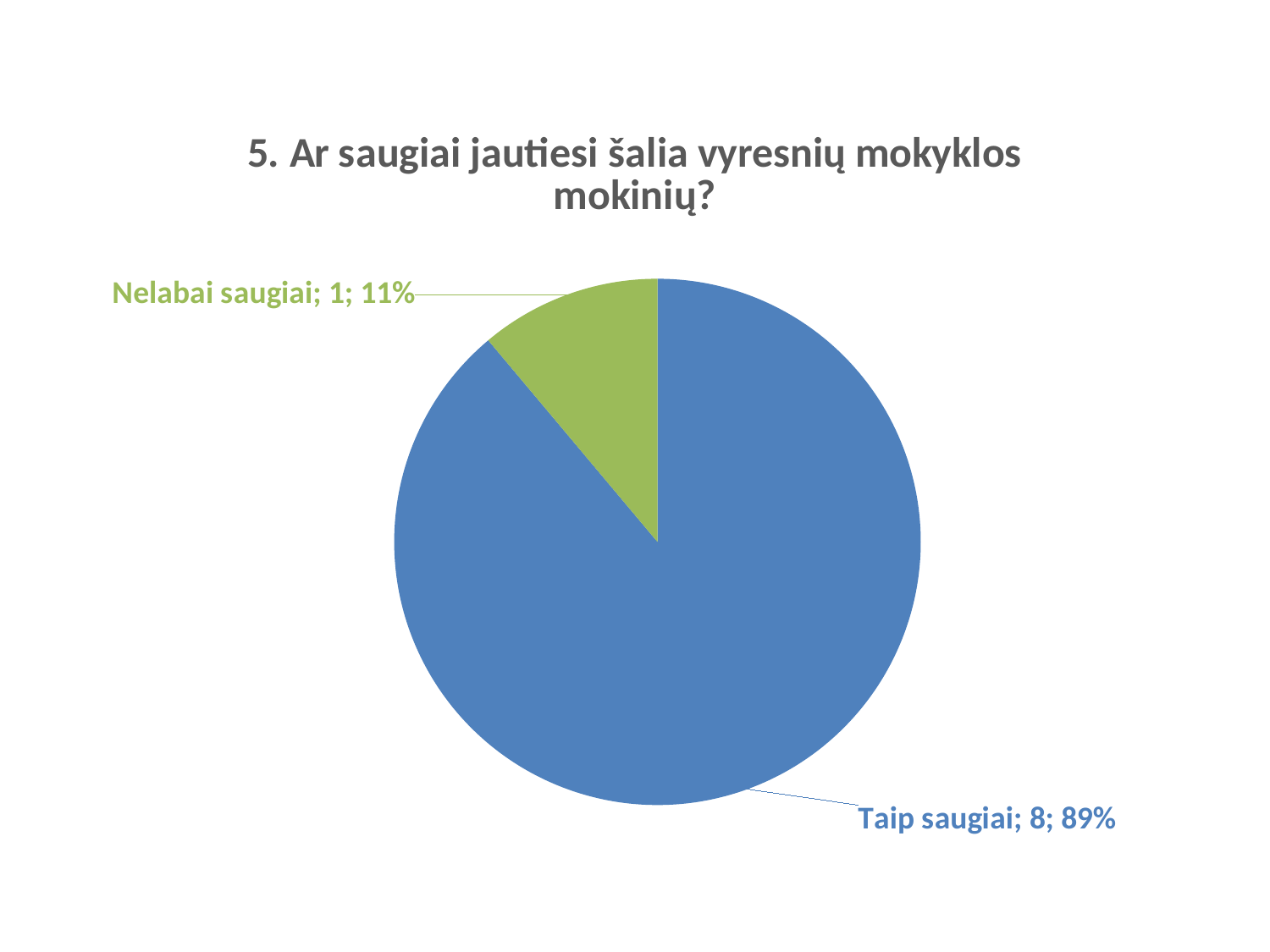
What share of the pie does "Taip saugiai" represent? 89% What is the difference between the counts for "Taip saugiai" and "Nelabai saugiai"? 7 Which category has the largest slice? Taip saugiai Which category has the smallest slice? Nelabai saugiai What share of the pie does "Nelabai saugiai" represent? 11% What kind of chart is shown on the slide? pie chart How many slices does the pie chart have? 2 What is the count for "Taip saugiai"? 8 What colour is the "Nelabai saugiai" slice? green What is the title of the chart? 5. Ar saugiai jautiesi šalia vyresnių mokyklos mokinių? Which is larger, the slice for "Taip saugiai" or the slice for "Nelabai saugiai"? Taip saugiai What is the count for "Nelabai saugiai"? 1